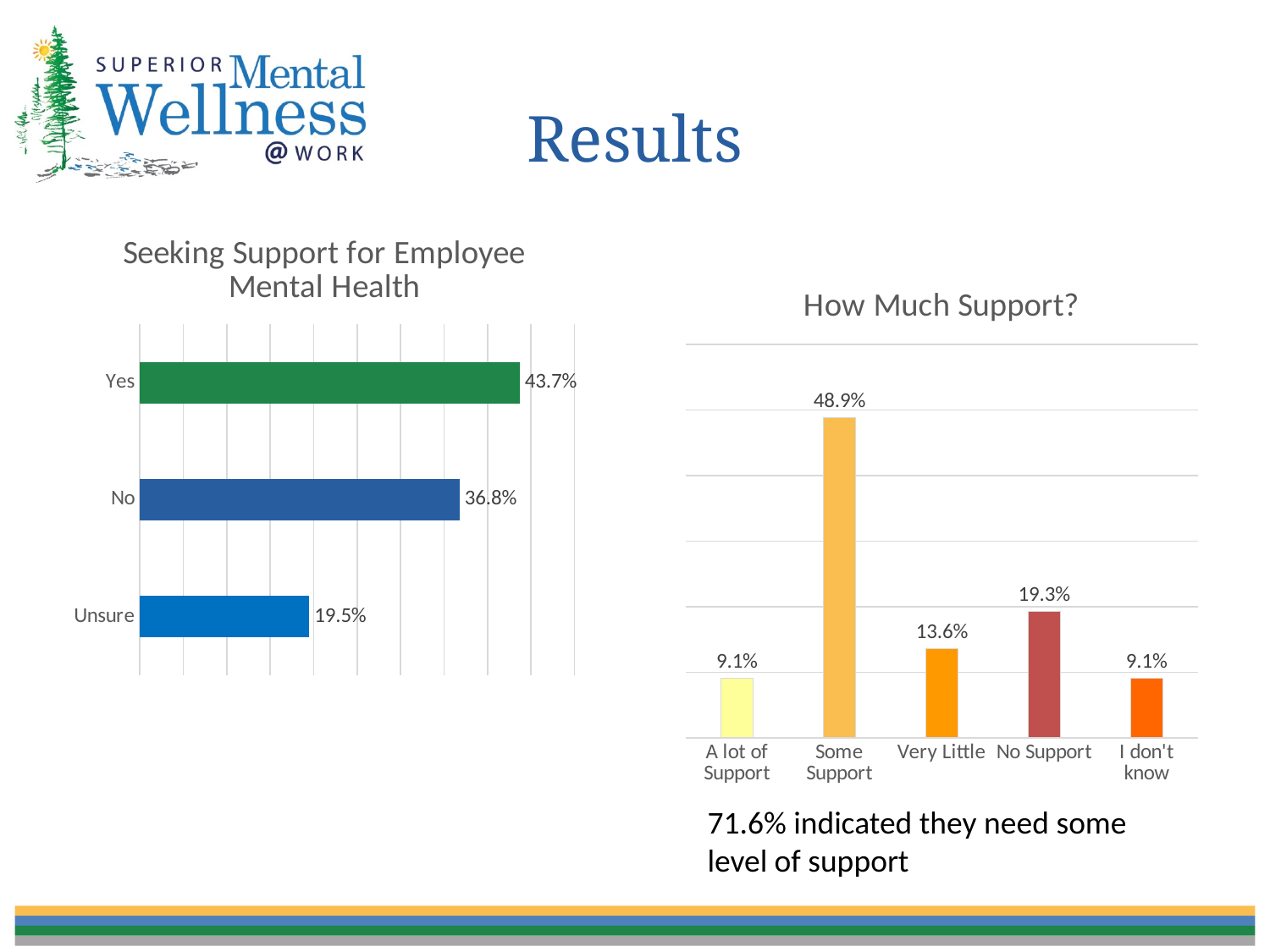
In the 'How Much Support?' chart, how many categories are shown? 5 In the 'Seeking Support for Employee Mental Health' chart, what is the value for Yes? 43.7% In the 'How Much Support?' chart, what is the value for Some Support? 48.9% In the 'Seeking Support for Employee Mental Health' chart, what is the difference between the Yes and No values? 6.9% What kind of chart is the 'Seeking Support for Employee Mental Health' chart? Bar chart In the 'How Much Support?' chart, which category has the highest value? Some Support In the 'Seeking Support for Employee Mental Health' chart, what is the value for Unsure? 19.5% In the 'Seeking Support for Employee Mental Health' chart, which category has the lowest value? Unsure In the 'How Much Support?' chart, what is the value for Very Little? 13.6% In the 'How Much Support?' chart, which is larger: No Support or Very Little? No Support In the 'How Much Support?' chart, what is the difference between Some Support and No Support? 29.6% In the 'Seeking Support for Employee Mental Health' chart, how many categories are shown? 3